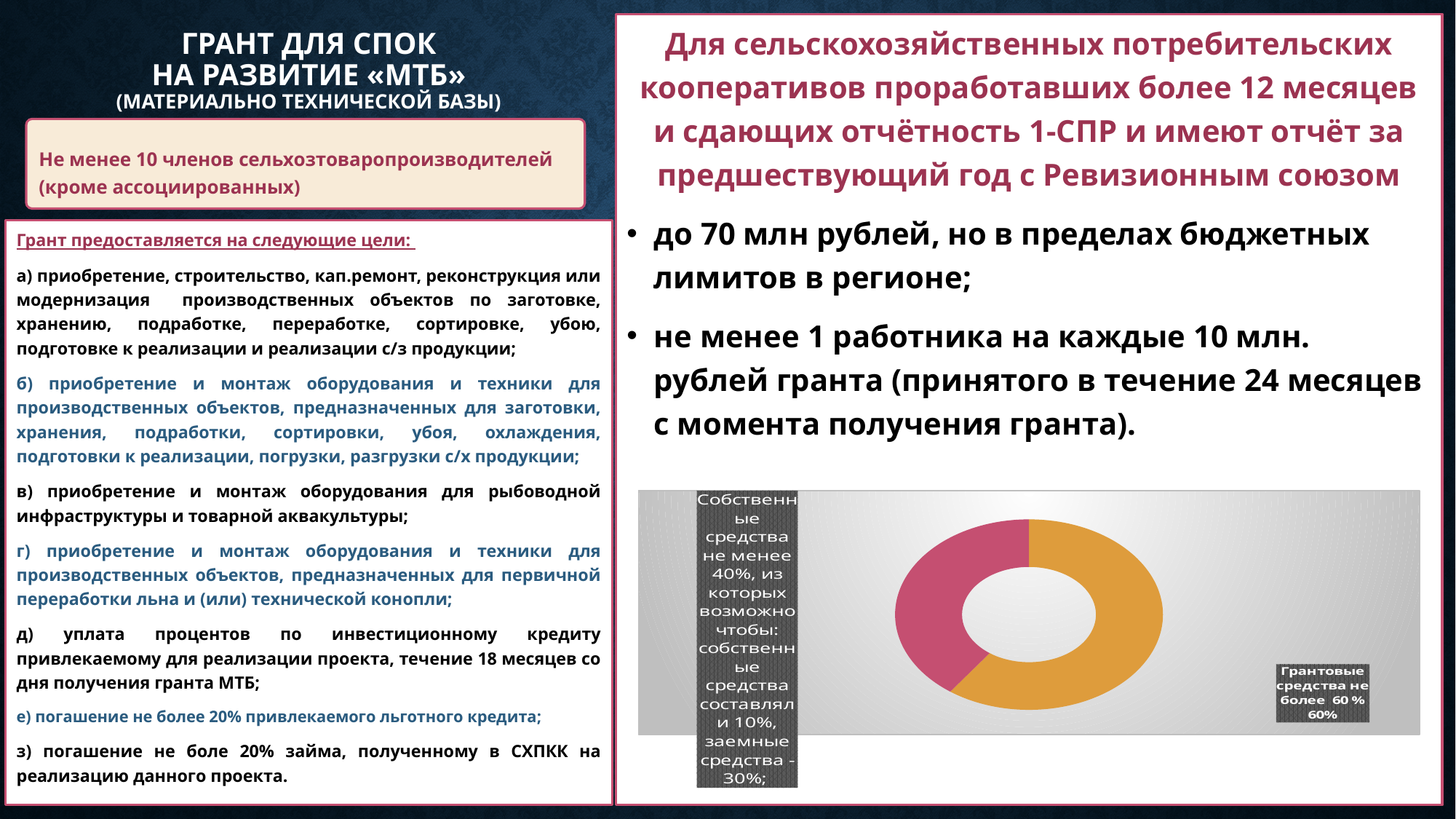
According to the own funds label, what share may be borrowed funds ("заемные средства")? 30% What colour is the own funds ("Собственные средства") slice in the doughnut chart? pink Which slice of the doughnut chart is the largest? Грантовые средства What percentage is printed on the data label for the grant funds ("Грантовые средства") slice? 60% Which slice of the doughnut chart is the smallest? Собственные средства What kind of chart is shown on the slide? doughnut (pie) chart What minimum share is stated in the label for own funds ("Собственные средства")? не менее 40% What is the difference between the grant funds share (60%) and the own funds share (40%) in the chart? 20% Which is larger in the doughnut chart: the grant funds slice or the own funds slice? Грантовые средства What share of the doughnut chart is labelled for "Грантовые средства"? 60% What colour is the grant funds ("Грантовые средства") slice in the doughnut chart? orange How many slices does the doughnut chart have? 2